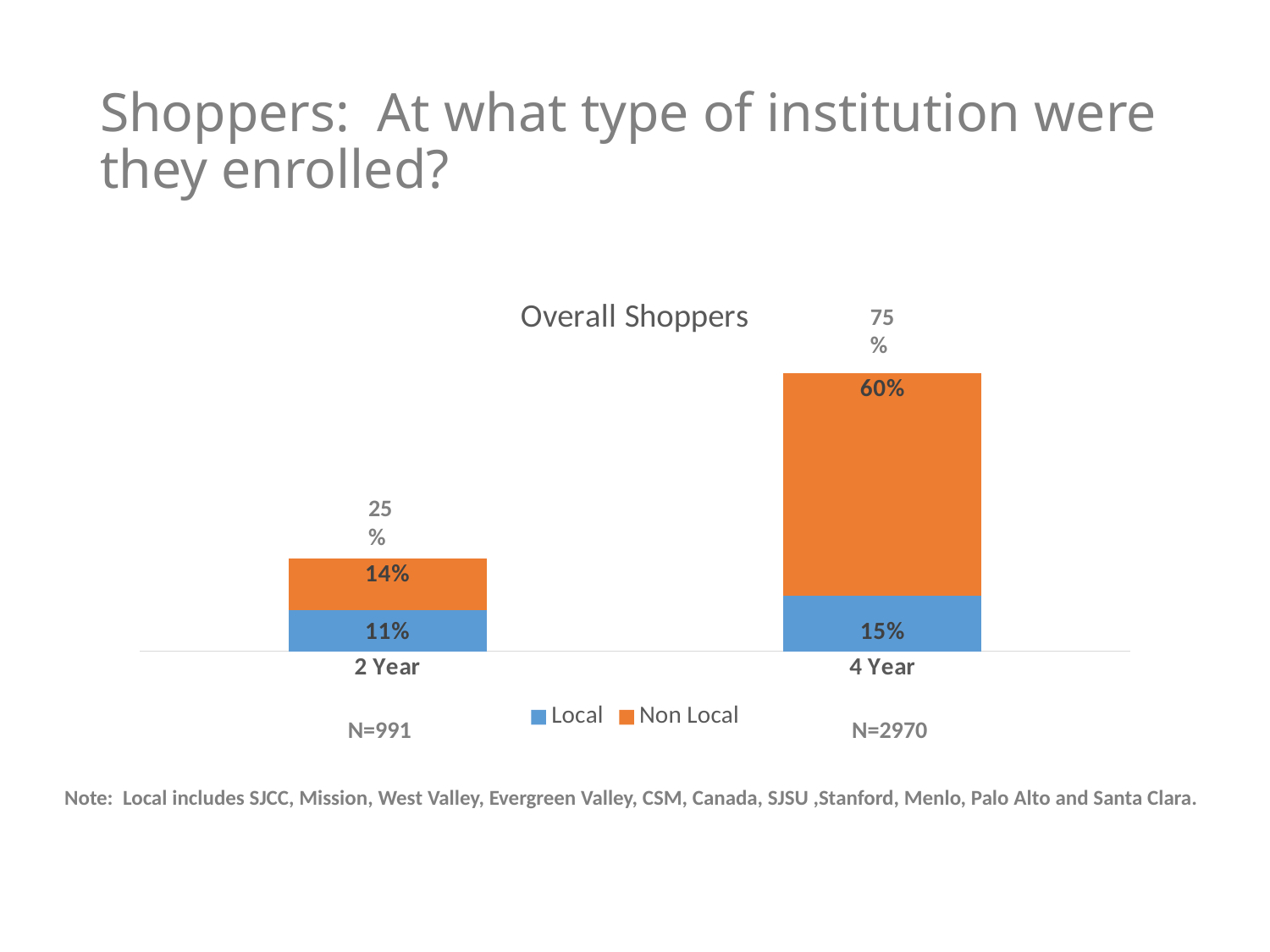
What is the total of the stacked bar for 4 Year? 75% What is the Non Local value for 4 Year? 60% Which category has the higher Non Local value, 2 Year or 4 Year? 4 Year What is the Local value for 2 Year? 11% What is the Non Local value for 2 Year? 14% Which category has the lowest Local value? 2 Year What is the total of the stacked bar for 2 Year? 25% How many series does the legend list? 2 What type of chart is shown? Stacked bar chart What is the Local value for 4 Year? 15% How many categories are shown on the x axis? 2 What is the difference between the Non Local values for 4 Year and 2 Year? 46%